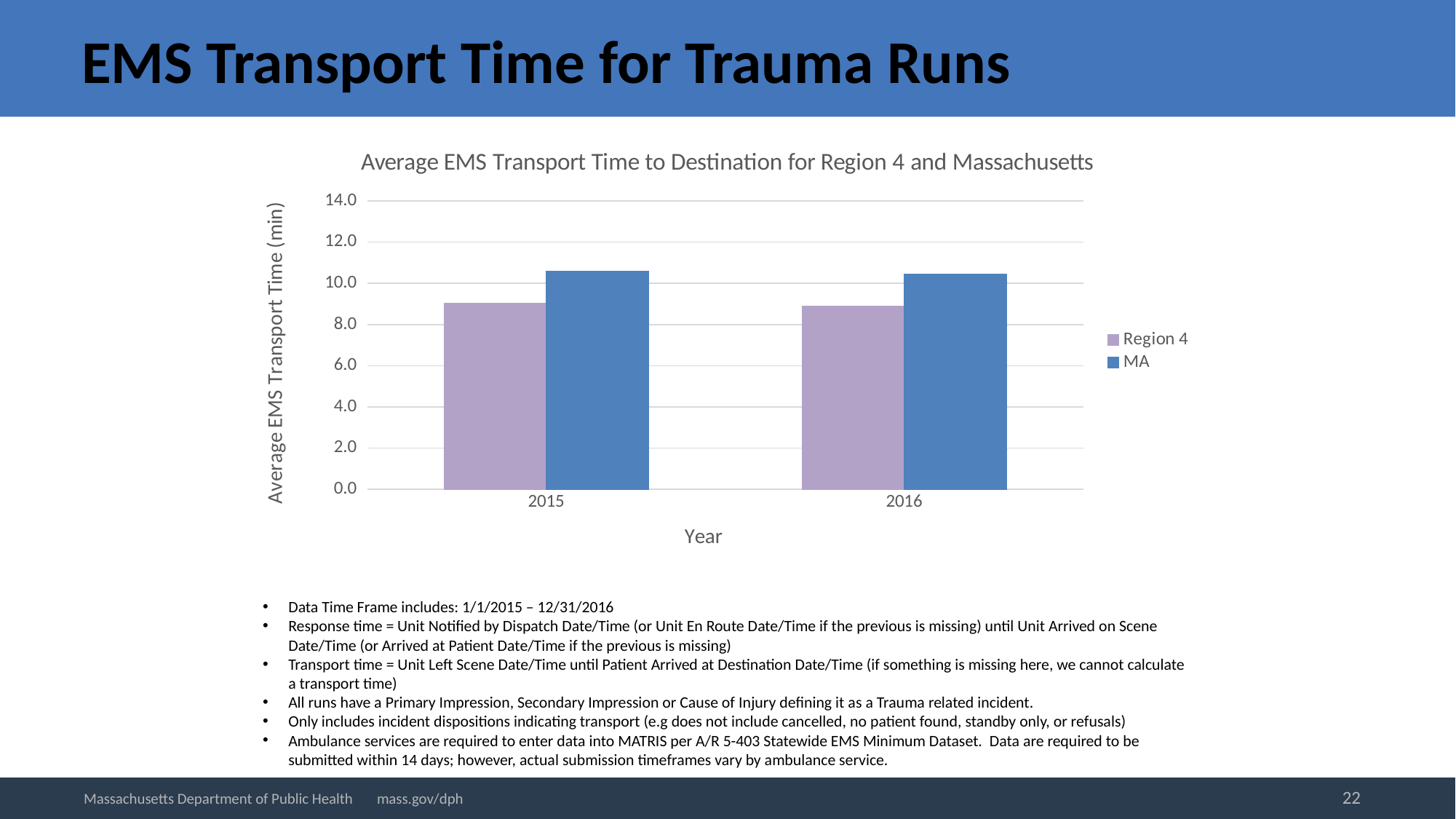
Is the value for Region 4 in 2015 greater or less than 8.0? greater What is the title of the chart? Average EMS Transport Time to Destination for Region 4 and Massachusetts How many series does the legend list? 2 What kind of chart is shown on the slide? bar chart Is the value for Region 4 in 2015 greater or less than 10.0? less Is the value for MA in 2015 greater or less than 10.0? greater Which series has the higher average transport time in 2016, Region 4 or MA? MA What is the label of the vertical axis? Average EMS Transport Time (min) How many years are shown on the x axis? 2 Which series has the higher average transport time in 2015, Region 4 or MA? MA